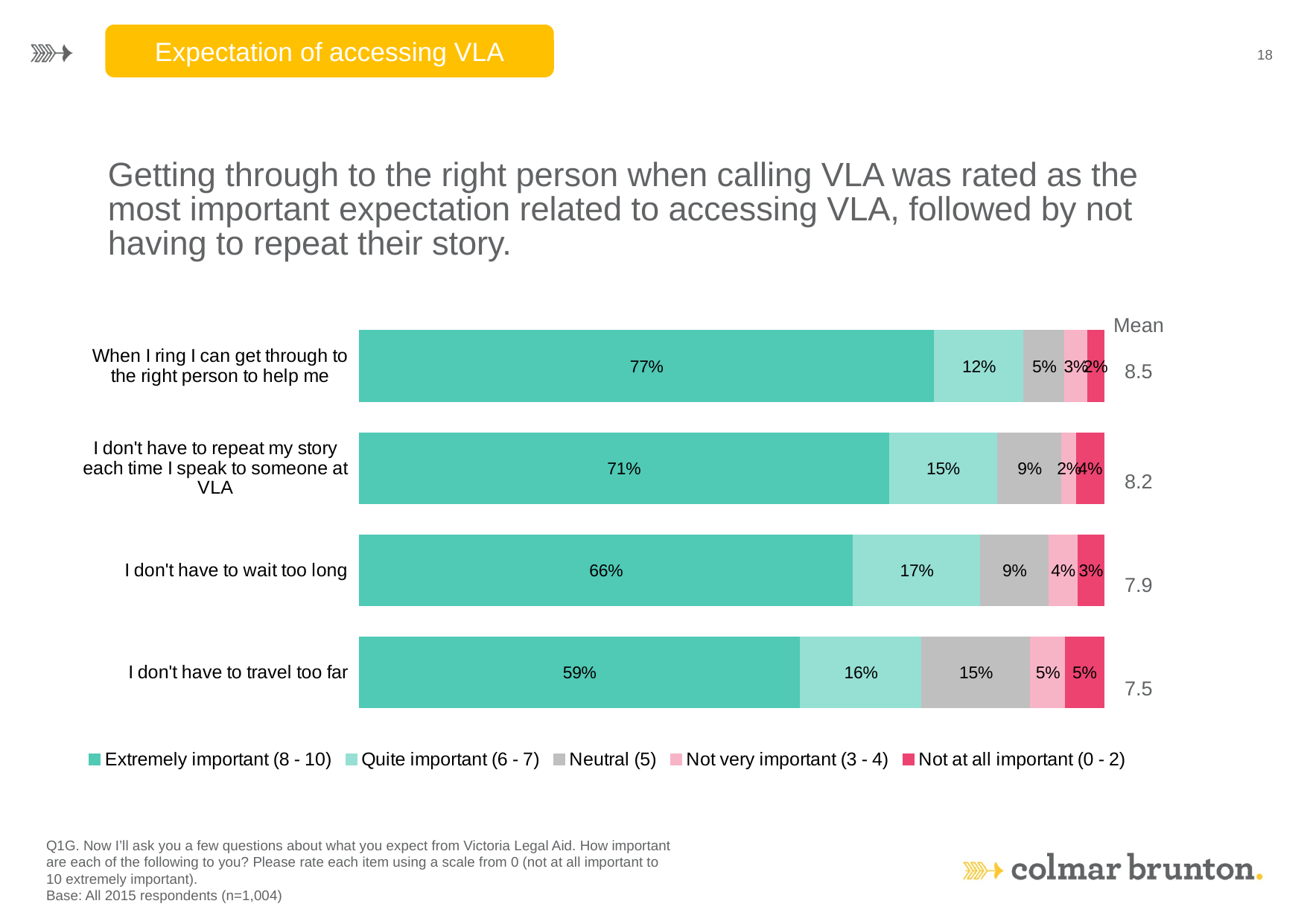
What percentage rated "I don't have to travel too far" as Neutral (5)? 15% What is the mean score shown for "I don't have to wait too long"? 7.9 What is the difference in the Extremely important (8 - 10) share between "When I ring I can get through to the right person to help me" and "I don't have to travel too far"? 18 percentage points How many series does the legend list? 5 What percentage rated "I don't have to travel too far" as Not at all important (0 - 2)? 5% What percentage rated "I don't have to wait too long" as Quite important (6 - 7)? 17% How many expectation items are plotted in the chart? 4 What percentage rated "When I ring I can get through to the right person to help me" as Extremely important (8 - 10)? 77% What kind of chart is shown on the slide? Stacked bar chart Which has a larger Neutral (5) share: "I don't have to repeat my story each time I speak to someone at VLA" or "I don't have to travel too far"? I don't have to travel too far Which expectation has the lowest mean score? I don't have to travel too far Which expectation has the highest share of Extremely important (8 - 10) ratings? When I ring I can get through to the right person to help me